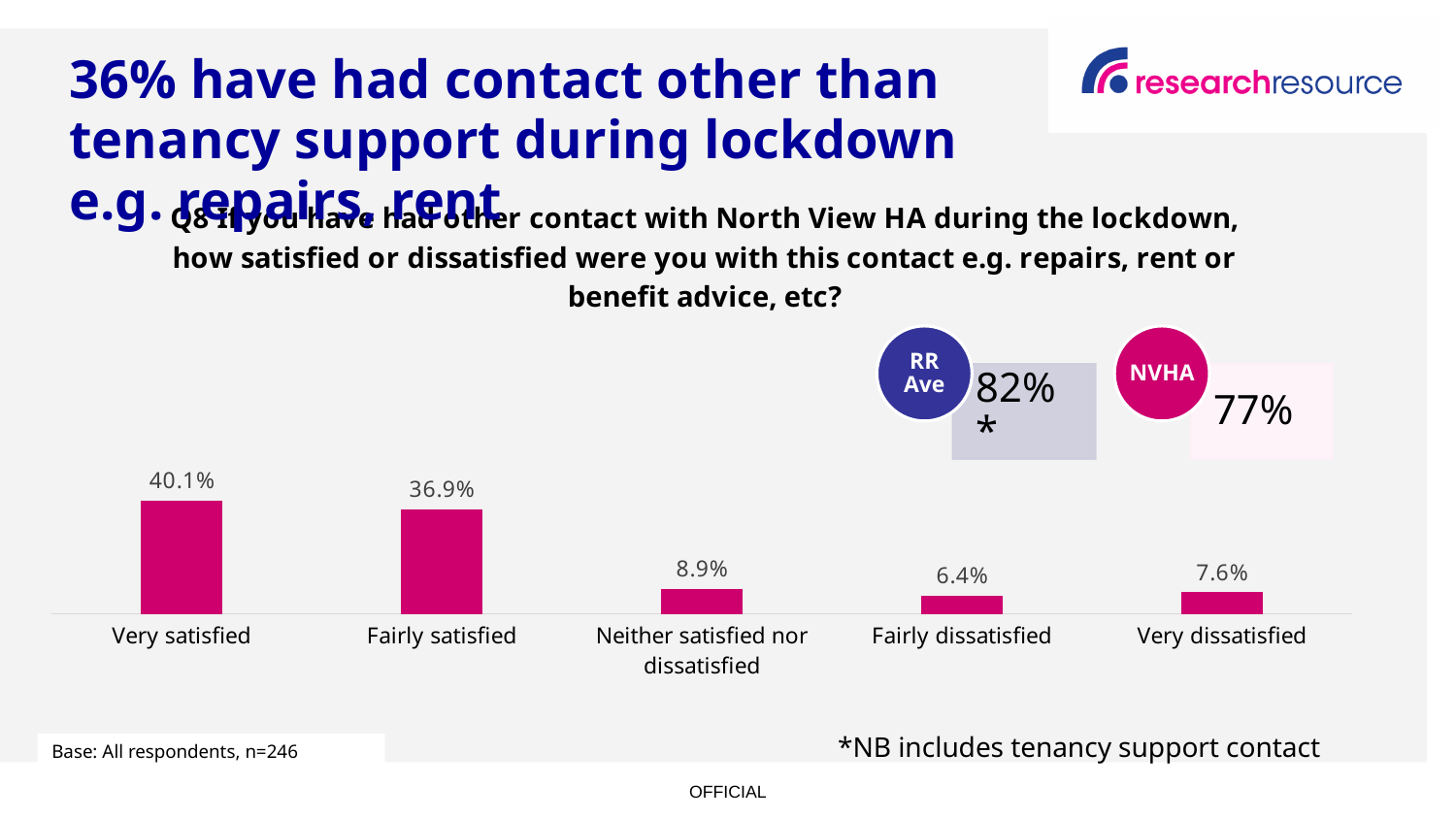
Which category has the lowest value? Fairly dissatisfied What is the value for Fairly dissatisfied? 6.4% What is the NVHA figure shown in the circle callout on the slide? 77% What is the value for Fairly satisfied? 36.9% What kind of chart is shown on the slide? Bar chart What is the value for Neither satisfied nor dissatisfied? 8.9% What is the value for Very satisfied? 40.1% What is the difference between Very satisfied and Fairly satisfied? 3.2% How many categories are shown in the chart? 5 Which category has the highest value? Very satisfied Which is larger, Very dissatisfied or Fairly dissatisfied? Very dissatisfied What is the value for Very dissatisfied? 7.6%